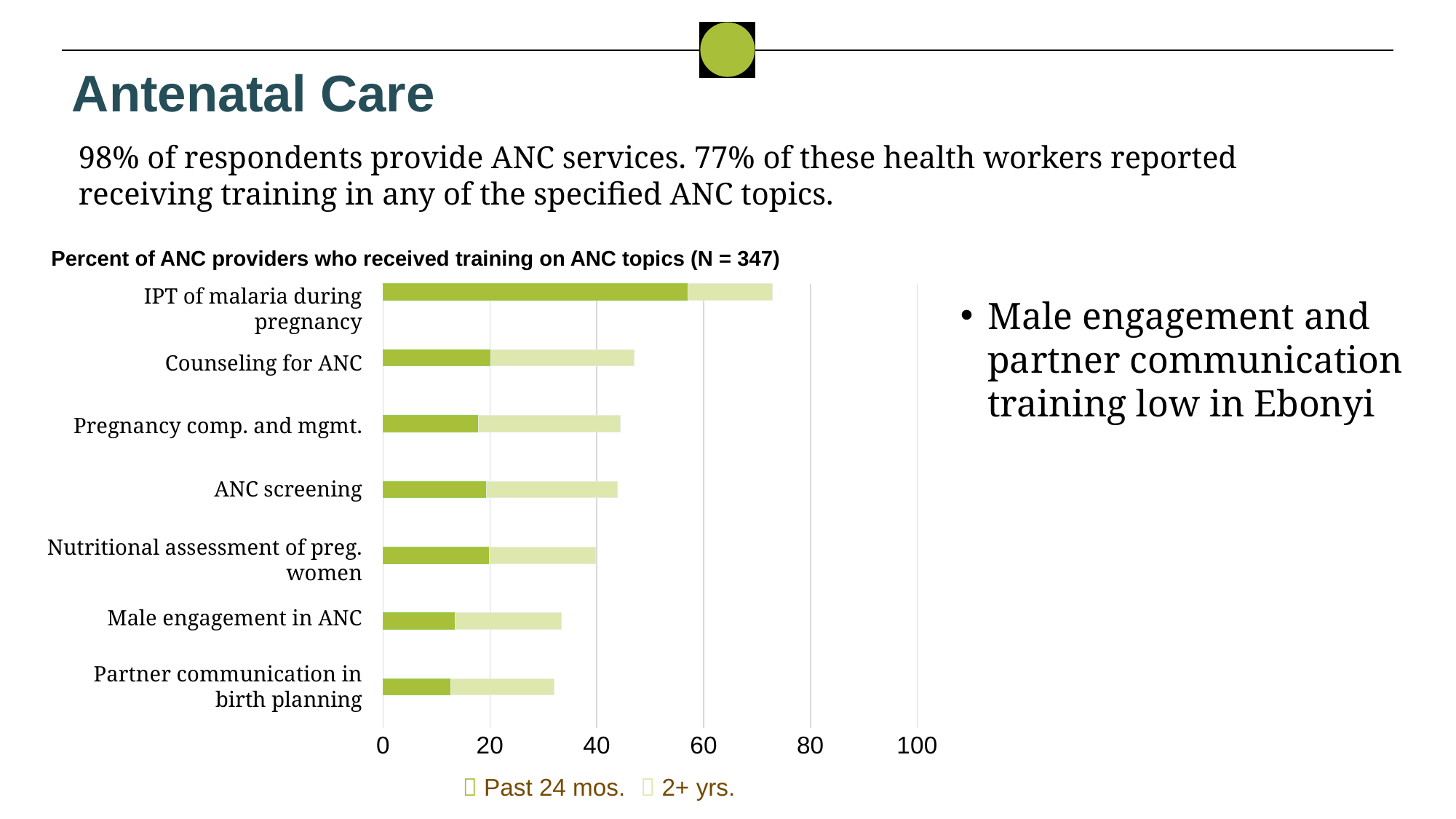
Which ANC topic has the highest total percentage of providers trained? IPT of malaria during pregnancy What kind of chart is shown on the slide? bar chart What are the two series named in the chart legend? Past 24 mos. and 2+ yrs. How many ANC topics (categories) are plotted in the chart? 7 Which has a larger total bar: 'Counseling for ANC' or 'Male engagement in ANC'? Counseling for ANC Is the total bar for 'Partner communication in birth planning' greater or less than 40? less How many series does the chart legend list? 2 Which ANC topic has the highest 'Past 24 mos.' value? IPT of malaria during pregnancy Is the total bar for 'Male engagement in ANC' greater or less than 40? less Is the 'Past 24 mos.' value for 'IPT of malaria during pregnancy' greater or less than 40? greater What is the title of the chart? Percent of ANC providers who received training on ANC topics (N = 347)